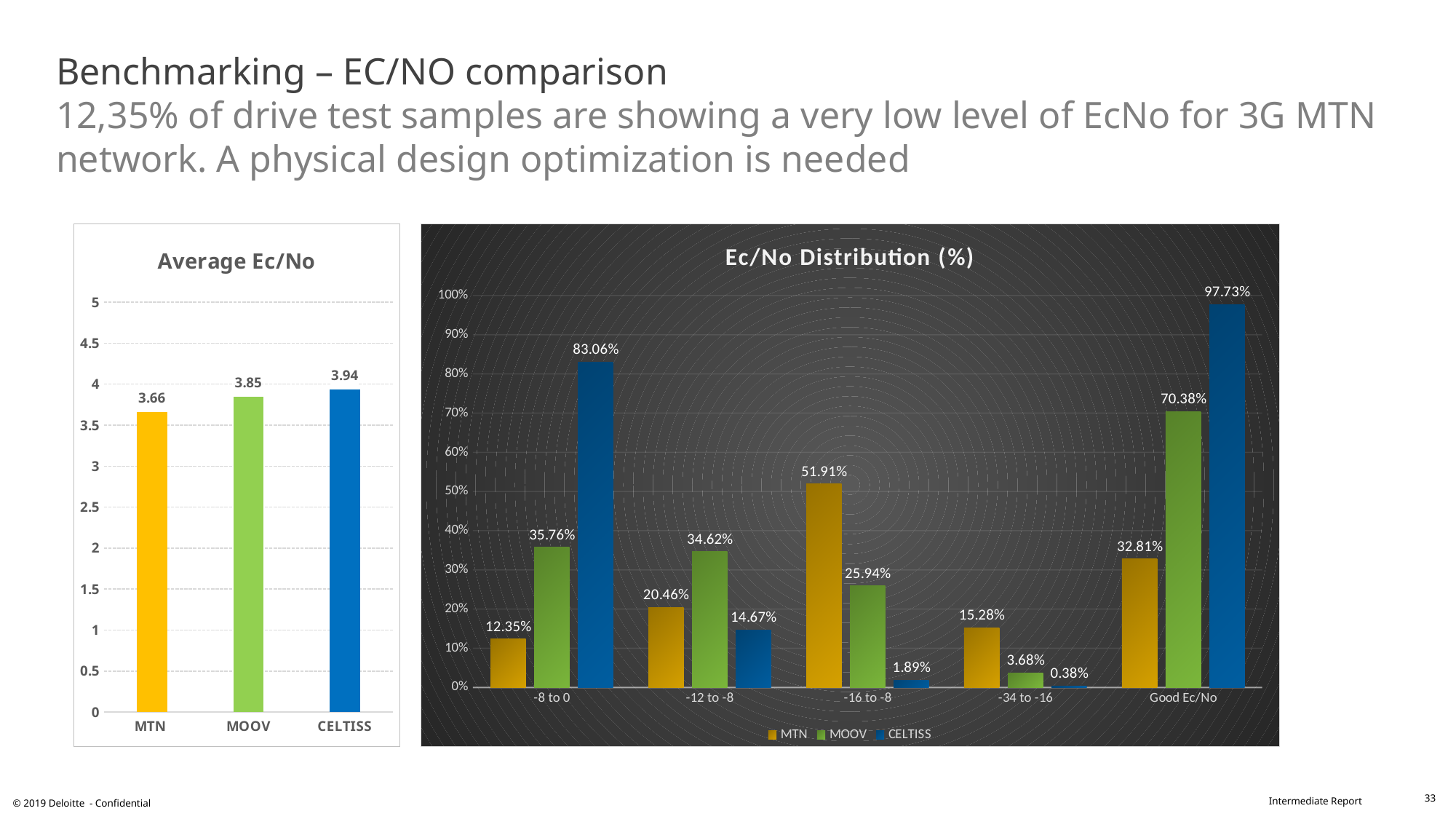
In the Ec/No Distribution (%) chart, how many series does the legend list? 3 In the Ec/No Distribution (%) chart, what is the CELTISS value for Good Ec/No? 97.73% In the Ec/No Distribution (%) chart, which series has the lowest value in the -34 to -16 category? CELTISS In the Ec/No Distribution (%) chart, which series has the highest value in the -8 to 0 category? CELTISS In the Average Ec/No chart, what is the difference between the CELTISS and MTN values? 0.28 In the Average Ec/No chart, which operator has the lowest average Ec/No? MTN In the Average Ec/No chart, which operator has the highest average Ec/No? CELTISS In the Ec/No Distribution (%) chart, is the MOOV value for -12 to -8 larger than the CELTISS value for -12 to -8? Yes What kind of chart is the Ec/No Distribution (%) chart? Bar chart In the Ec/No Distribution (%) chart, what is the MTN value for the -16 to -8 category? 51.91% In the Average Ec/No chart, how many operators are shown? 3 In the Average Ec/No chart, what is the value for MTN? 3.66